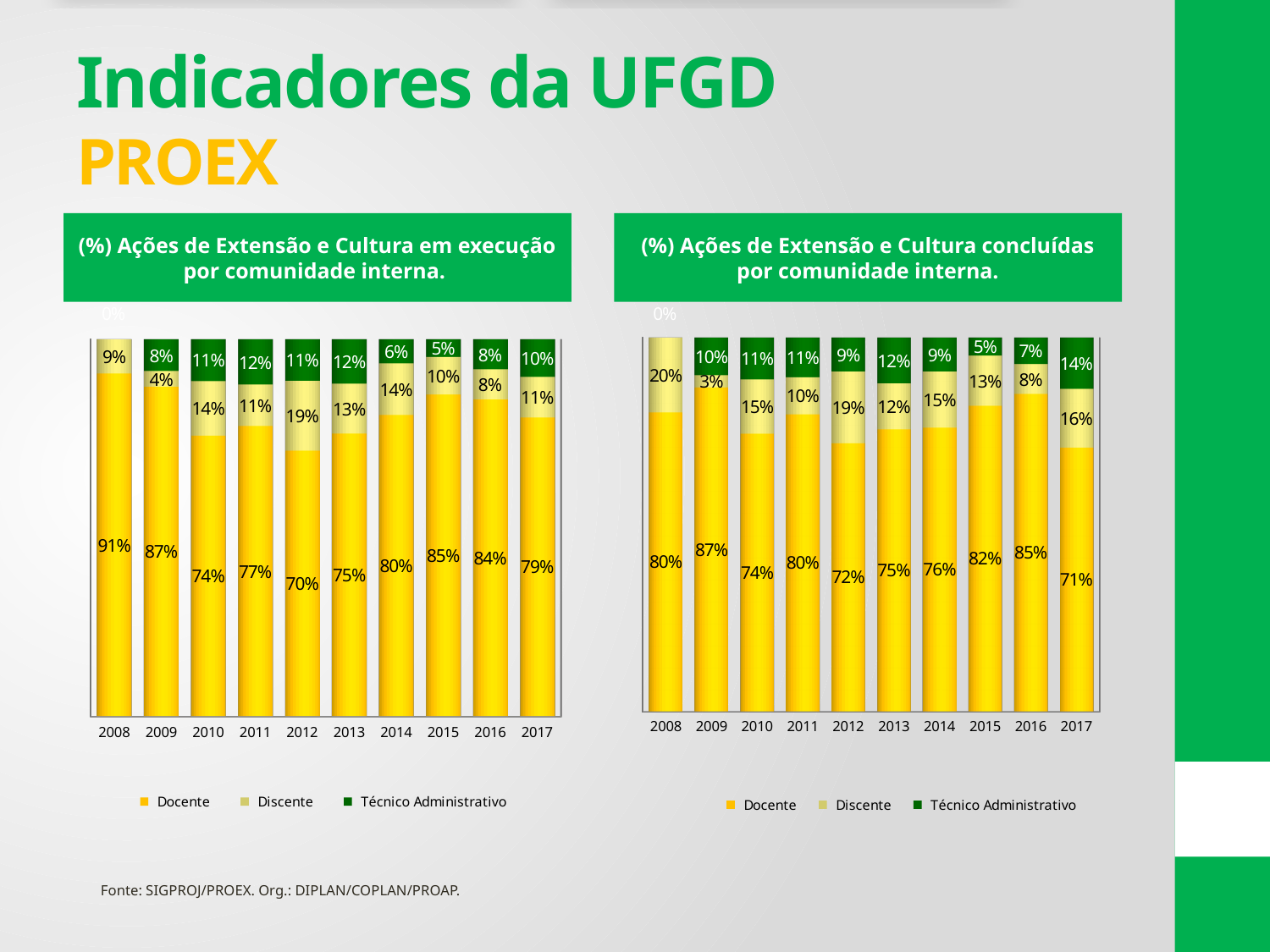
In the right chart '(%) Ações de Extensão e Cultura concluídas por comunidade interna', what is the Discente value for 2008? 20% What kind of chart is the right chart '(%) Ações de Extensão e Cultura concluídas por comunidade interna'? Stacked bar chart In the right chart '(%) Ações de Extensão e Cultura concluídas por comunidade interna', which year has the lowest Docente value? 2017 In the right chart '(%) Ações de Extensão e Cultura concluídas por comunidade interna', what is the Técnico Administrativo value for 2017? 14% In the left chart '(%) Ações de Extensão e Cultura em execução por comunidade interna', which year has the highest Docente value? 2008 In the left chart '(%) Ações de Extensão e Cultura em execução por comunidade interna', which year has the lowest Técnico Administrativo value? 2008 In the left chart '(%) Ações de Extensão e Cultura em execução por comunidade interna', what is the Docente value for 2012? 70% In the left chart '(%) Ações de Extensão e Cultura em execução por comunidade interna', what is the Discente value for 2014? 14% In the right chart '(%) Ações de Extensão e Cultura concluídas por comunidade interna', is the Docente value for 2009 or 2012 larger? 2009 How many series does the legend of the left chart '(%) Ações de Extensão e Cultura em execução por comunidade interna' list? 3 In the left chart '(%) Ações de Extensão e Cultura em execução por comunidade interna', what is the difference between the Docente values for 2008 and 2012? 21% How many years are shown on the x axis of the right chart '(%) Ações de Extensão e Cultura concluídas por comunidade interna'? 10